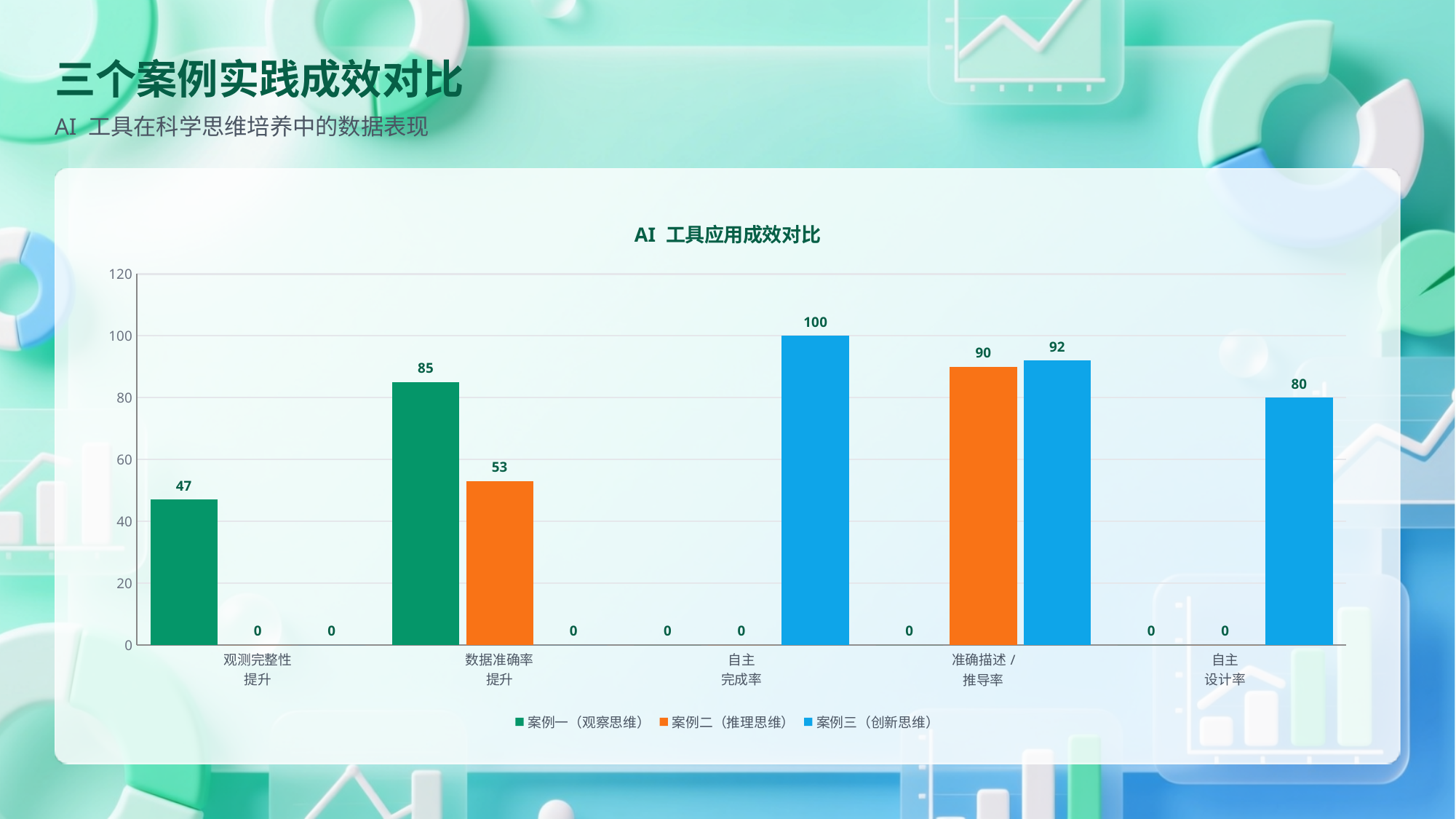
What is the value of 案例三（创新思维） for 自主设计率? 80 Which category has the highest value for 案例三（创新思维）? 自主完成率 What is the value of 案例一（观察思维） for 观测完整性提升? 47 Which category has the highest value for 案例一（观察思维）? 数据准确率提升 How many categories are shown on the x axis? 5 What is the title of the chart? AI 工具应用成效对比 What is the value of 案例二（推理思维） for 数据准确率提升? 53 How many series does the legend list? 3 For 准确描述 / 推导率, which is larger: 案例二（推理思维） or 案例三（创新思维）? 案例三（创新思维） What is the value of 案例三（创新思维） for 自主完成率? 100 What is the difference between 案例一（观察思维） and 案例二（推理思维） for 数据准确率提升? 32 What type of chart is shown on the slide? bar chart